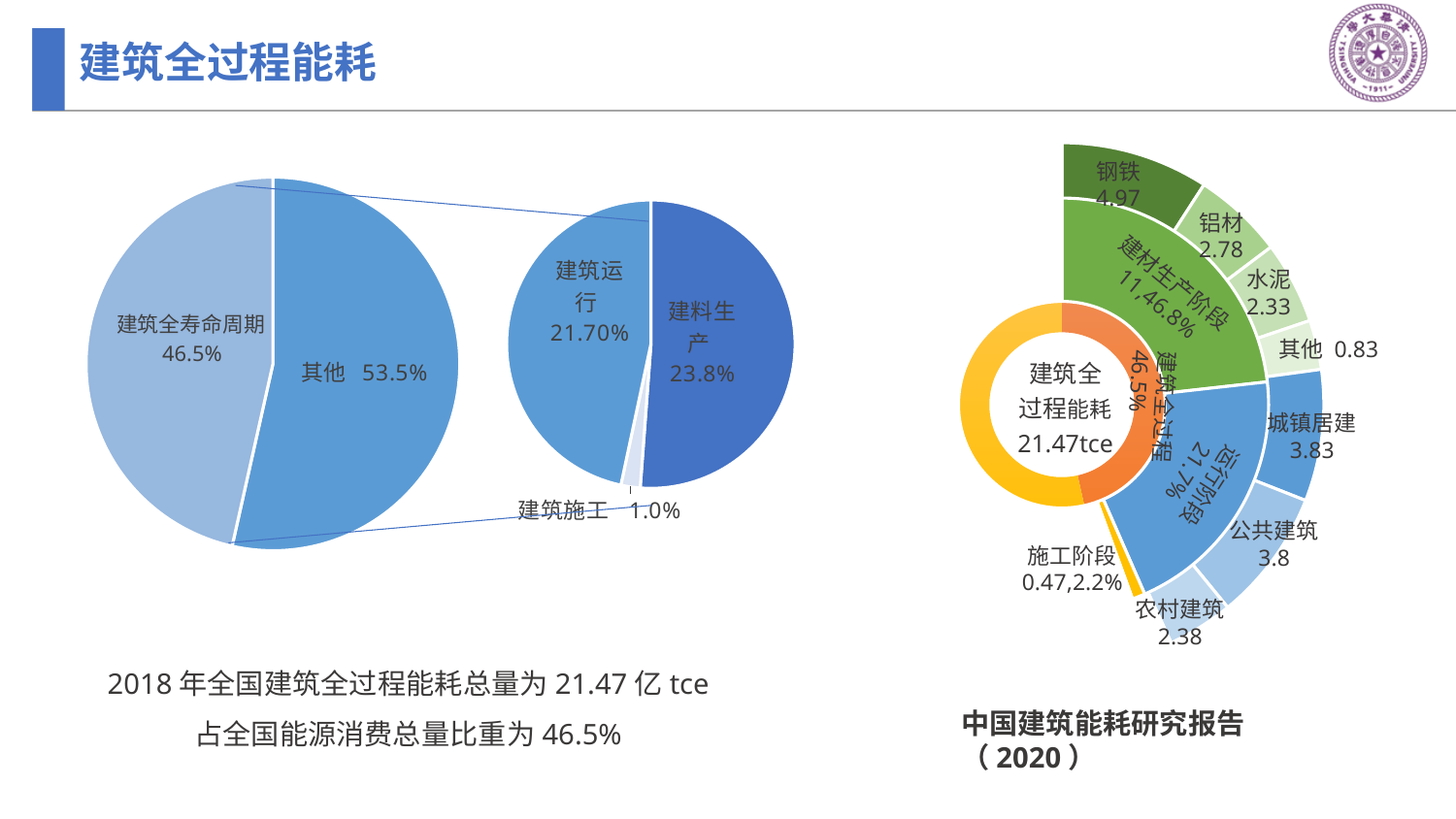
In the right sunburst chart, what text is shown in the centre? 建筑全过程能耗 21.47tce In the left chart's secondary pie, what share is labelled for 建筑施工? 1.0% In the right sunburst chart, which is larger, the value for 铝材 or the value for 水泥? 铝材 What kind of chart is shown on the right side of the slide? Sunburst chart In the right sunburst chart, what value is labelled for 城镇居建? 3.83 In the left pie-of-pie chart, what share is labelled for 建筑全寿命周期? 46.5% In the left chart's secondary pie, what is the difference between the shares of 建料生产 and 建筑运行? 2.1% In the left pie-of-pie chart, what share is labelled for 其他? 53.5% In the right sunburst chart, what value is labelled for 钢铁? 4.97 In the left chart's secondary pie, which segment is the largest? 建料生产 In the left chart's secondary pie, which segment is the smallest? 建筑施工 In the left chart's secondary pie, what share is labelled for 建筑运行? 21.70%